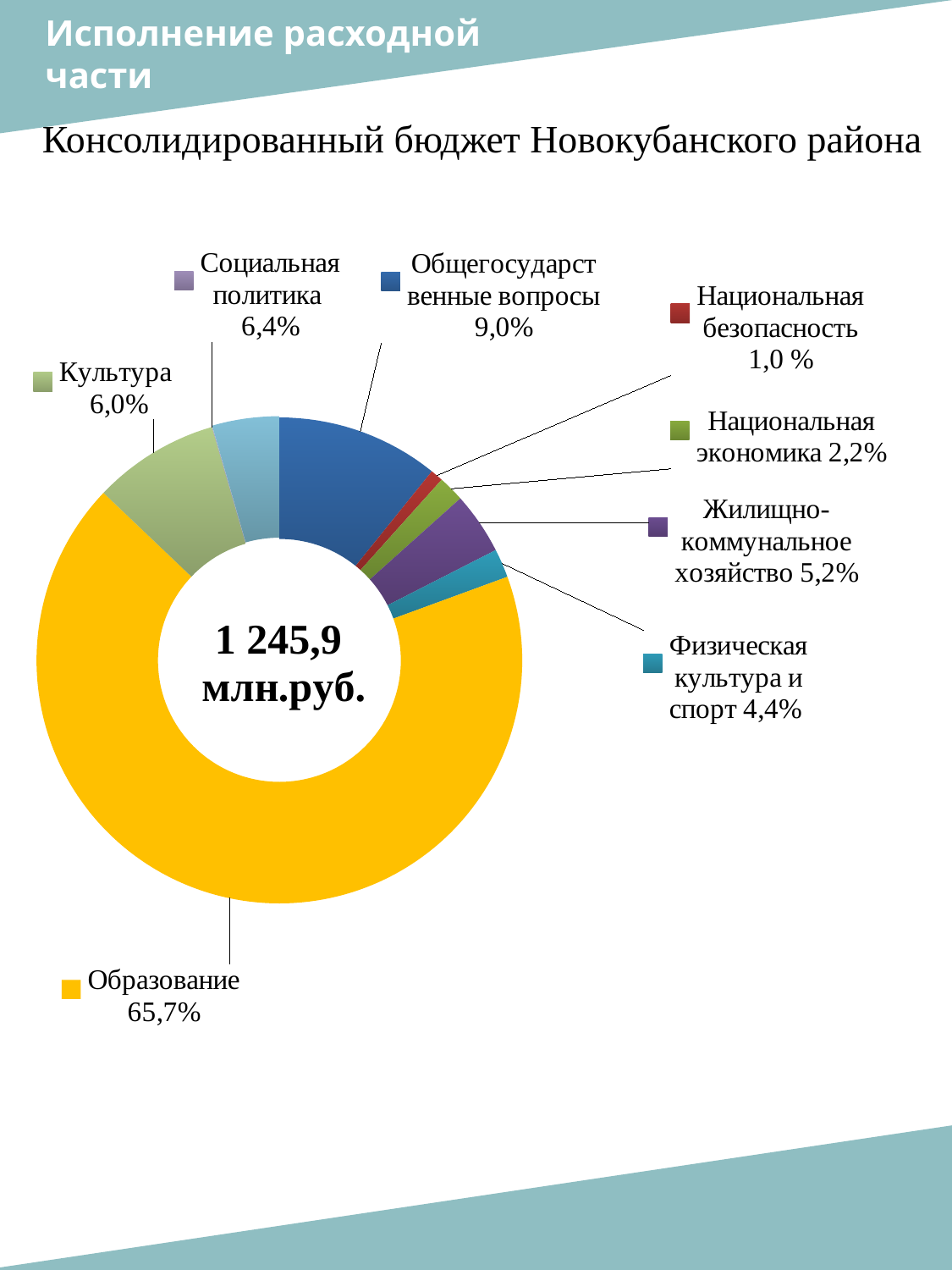
What share of the budget goes to Образование? 65,7% What share is shown for Общегосударственные вопросы? 9,0% What total amount is written in the centre of the chart? 1 245,9 млн.руб. Which category has the smallest share of the chart? Национальная безопасность What share is shown for Физическая культура и спорт? 4,4% What kind of chart is shown on the slide? doughnut chart Which has a larger share, Национальная экономика or Физическая культура и спорт? Физическая культура и спорт What is the title written above the chart? Консолидированный бюджет Новокубанского района How many categories are shown in the chart? 8 Which category has the largest share of the chart? Образование What percentage is labelled for Жилищно-коммунальное хозяйство? 5,2% What is the difference in percentage points between Социальная политика and Культура? 0,4